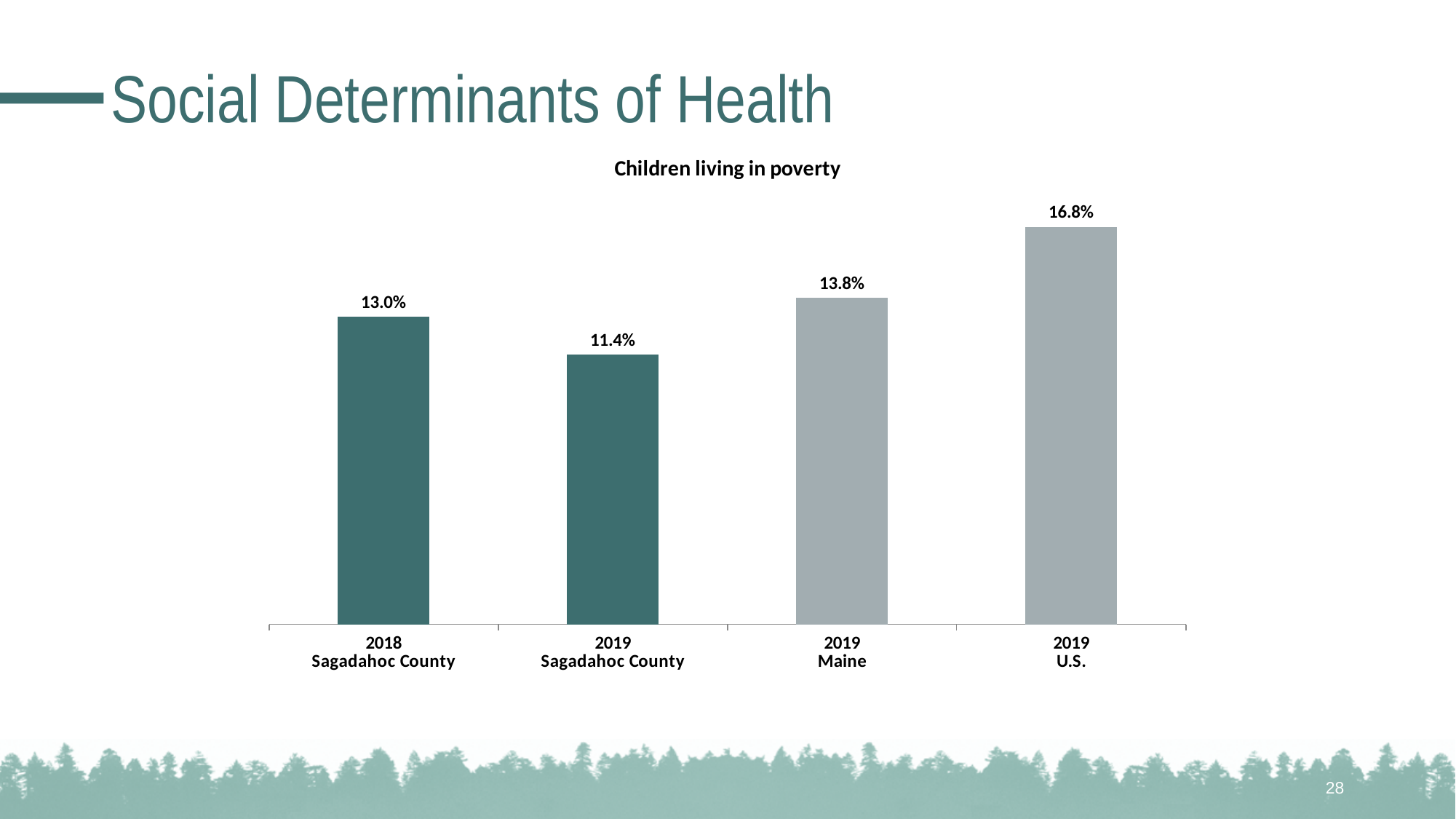
Which category has the highest value? 2019 U.S. What is the value for 2018 Sagadahoc County? 13.0% What is the value for 2019 Maine? 13.8% What is the value for 2019 U.S.? 16.8% What is the value for 2019 Sagadahoc County? 11.4% What is the title of the chart? Children living in poverty What is the difference between the 2019 U.S. value and the 2019 Sagadahoc County value? 5.4% Which is larger, the value for 2019 Maine or the value for 2019 Sagadahoc County? 2019 Maine Which category has the lowest value? 2019 Sagadahoc County What kind of chart is shown on the slide? Bar chart How many bars are shown in the chart? 4 What is the difference between the 2018 and 2019 Sagadahoc County values? 1.6%